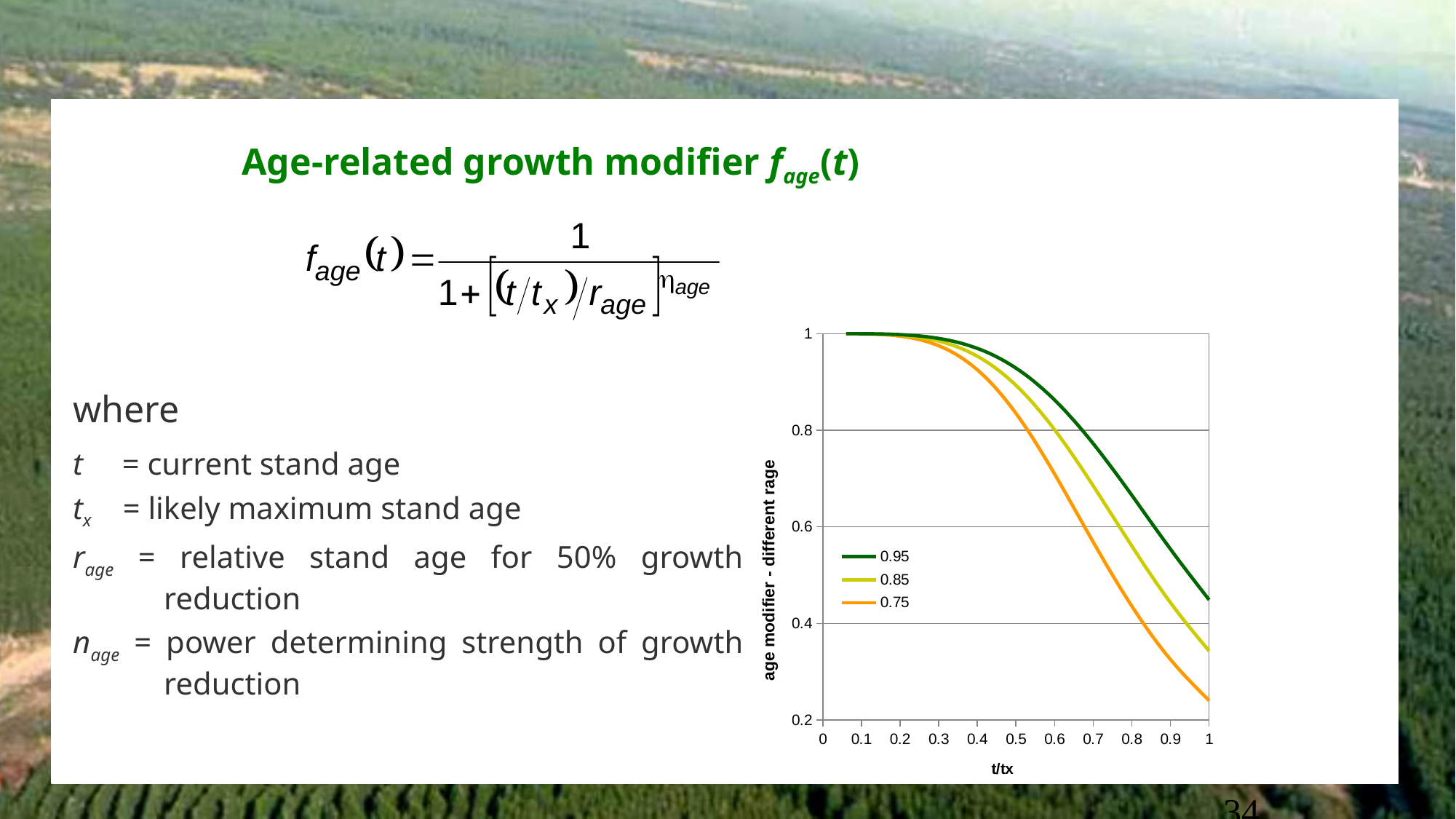
What are the three series listed in the chart legend? 0.95, 0.85, 0.75 What is the title of the chart's x axis? t/tx Do the values of the 0.95 series rise or fall as t/tx increases? fall Which series has the highest value at t/tx = 1? 0.95 At t/tx = 1, is the value of the 0.95 series greater or less than 0.4? greater At t/tx = 0.6, is the value of the 0.75 series greater or less than 0.8? less What kind of chart is shown on the slide? line chart At t/tx = 1, is the value of the 0.75 series greater or less than 0.4? less How many series does the chart legend list? 3 At t/tx = 0.8, which series has the larger value, 0.95 or 0.75? 0.95 Which series has the lowest value at t/tx = 1? 0.75